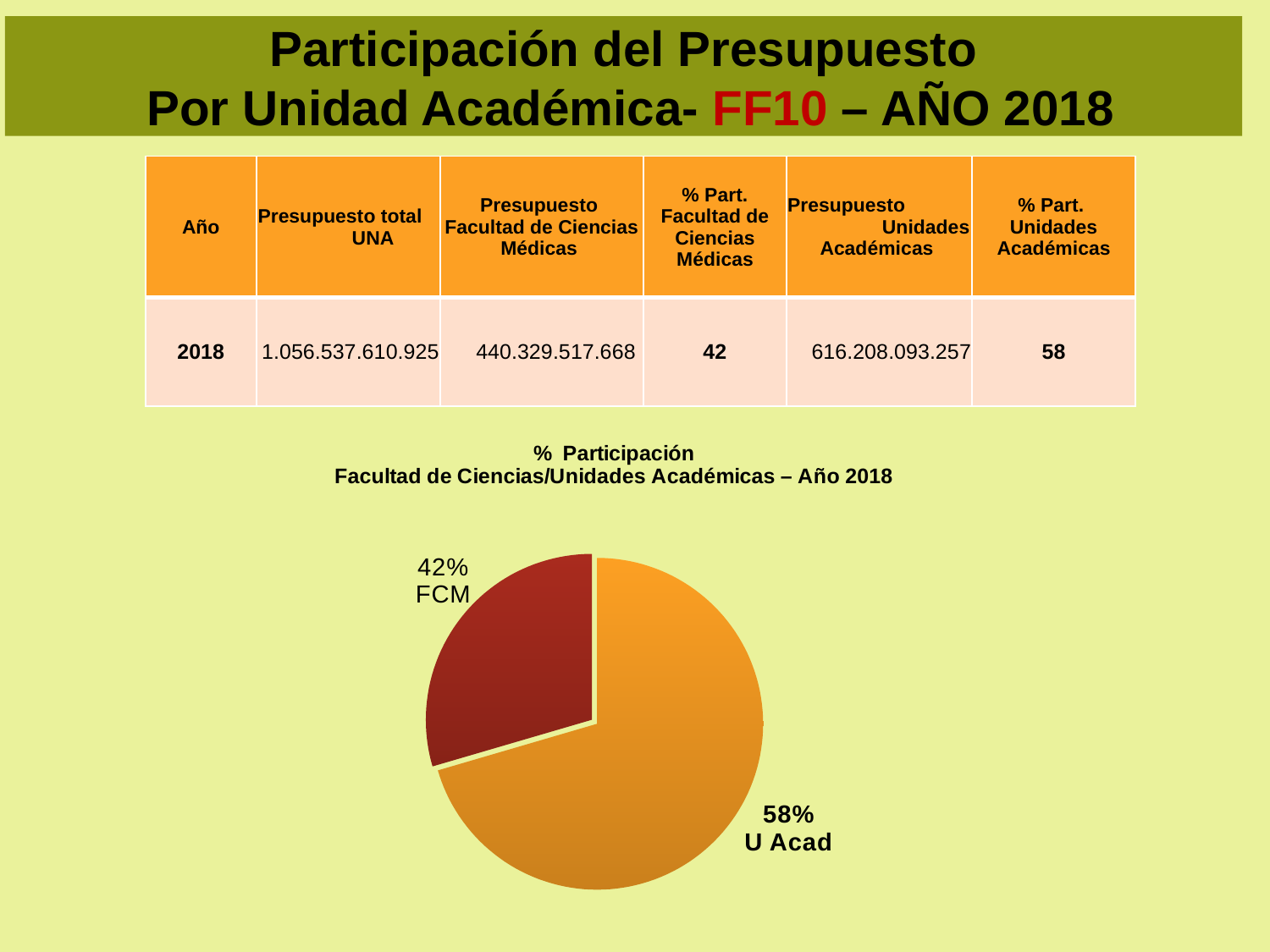
Which slice of the pie is the largest? U Acad What share of the pie does U Acad represent? 58% What colour is the FCM slice of the pie? dark red Which is larger, the FCM slice or the U Acad slice? U Acad How many slices does the pie chart have? 2 What kind of chart is shown on the slide? pie chart What is the title of the pie chart? % Participación Facultad de Ciencias/Unidades Académicas – Año 2018 Is the share for FCM greater or less than 50%? less What share of the pie does FCM represent? 42% What is the difference in percentage points between the U Acad slice and the FCM slice? 16 Which slice of the pie is the smallest? FCM